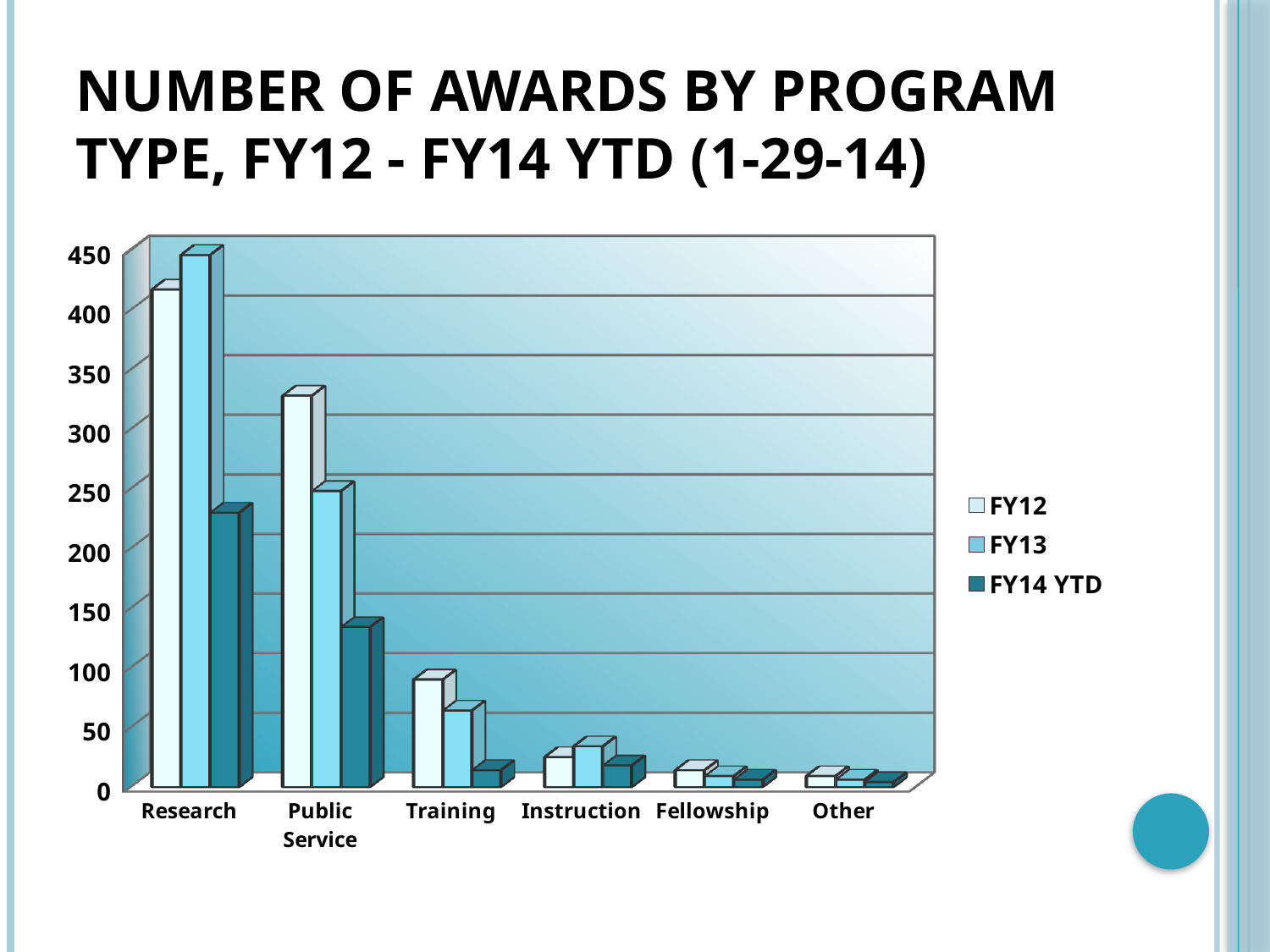
What is the last entry listed in the legend? FY14 YTD How many series does the legend list? 3 How many program type categories are shown on the x axis? 6 Is the FY12 value for Public Service greater or less than 300? greater For Public Service, which is larger: the FY12 value or the FY13 value? FY12 For Research, which is larger: the FY12 value or the FY13 value? FY13 Which program type has the highest FY13 value? Research What kind of chart is shown on the slide? bar chart Is the FY14 YTD value for Research greater or less than 200? greater Do the FY12 values rise or fall moving from Research to Other along the x axis? fall Which program type has the lowest FY12 value? Other Is the FY13 value for Research greater or less than 400? greater